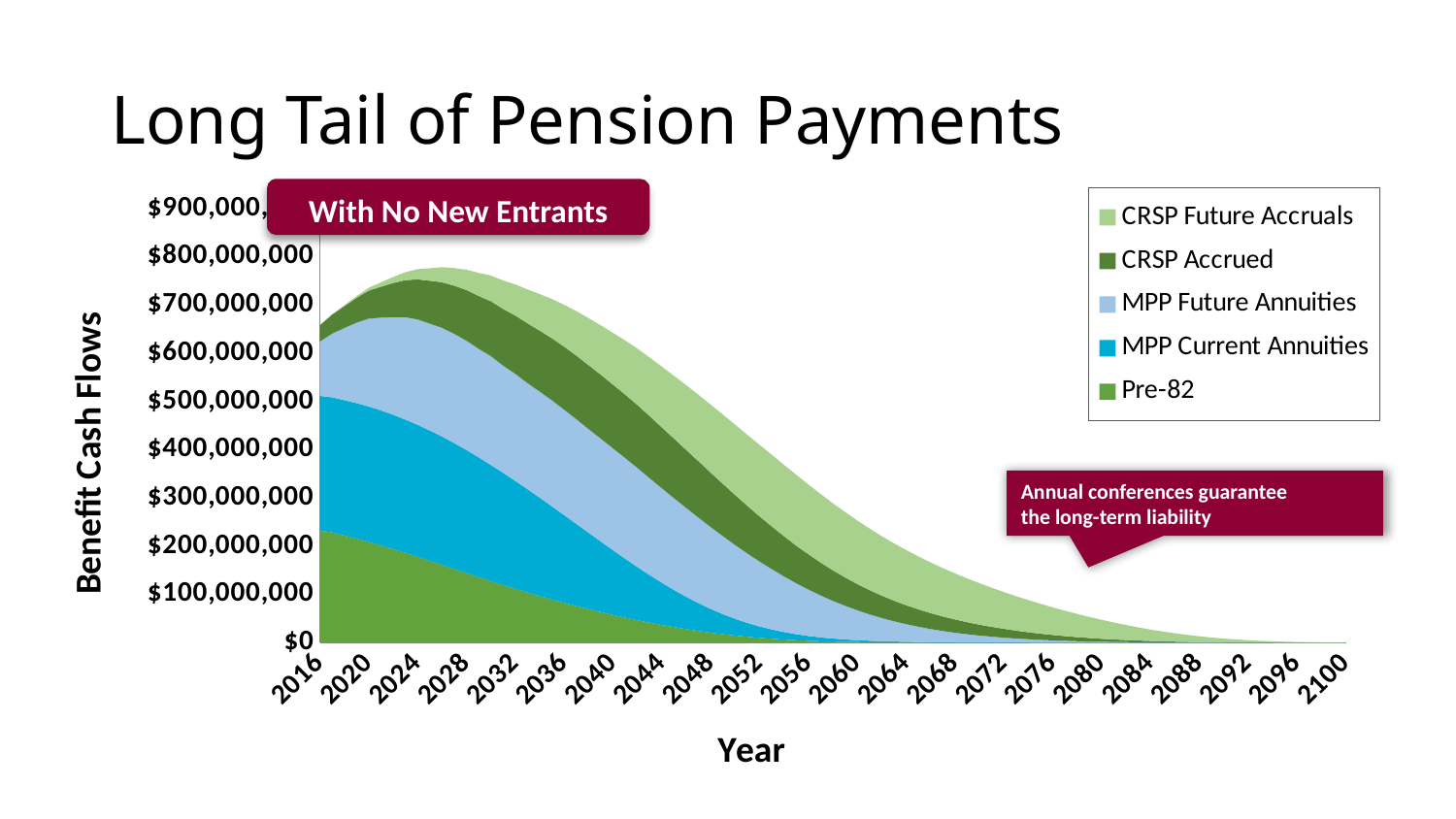
How many year labels are shown along the x axis? 22 Is the total benefit cash flow in 2016 greater or less than $600,000,000? greater What text appears in the callout box at the top of the chart? With No New Entrants Is the total benefit cash flow at its peak around 2028 greater or less than $700,000,000? greater Is the total benefit cash flow in 2068 greater or less than $100,000,000? greater Do the total benefit cash flows rise or fall from 2016 to 2024? rise What kind of chart is shown on the slide? Stacked area chart Which series is at the bottom of the stacked areas? Pre-82 Do the total benefit cash flows rise or fall from 2040 to 2100? fall How many series does the legend list? 5